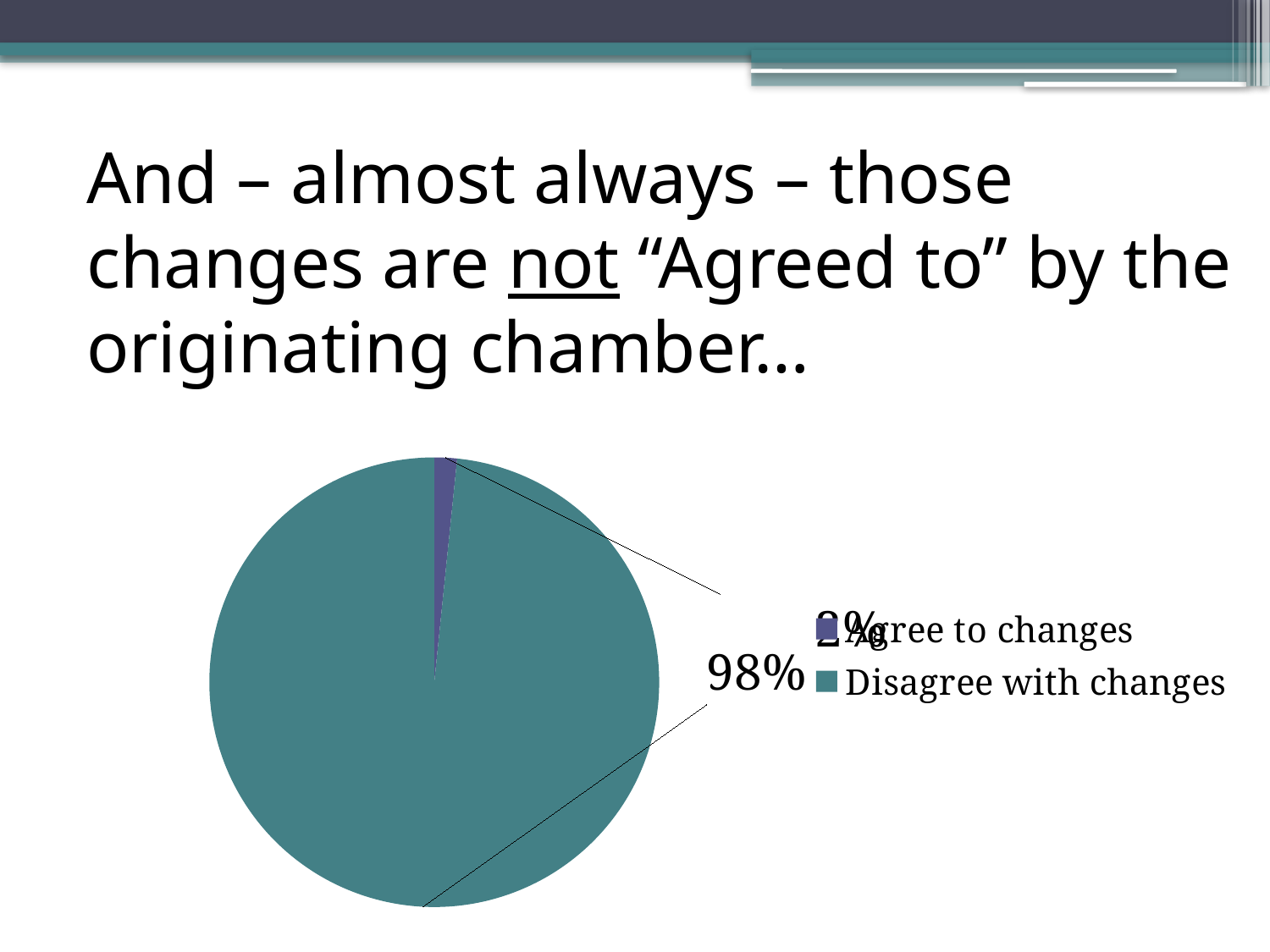
What colour is the "Disagree with changes" slice? teal How many entries does the legend list? 2 How many slices does the pie chart have? 2 Which is larger, the share for "Agree to changes" or the share for "Disagree with changes"? Disagree with changes What colour is the "Agree to changes" slice? purple What kind of chart is shown on the slide? pie chart What share of the pie does "Disagree with changes" represent? 98% What share of the pie does "Agree to changes" represent? 2% What is the difference in percentage points between the "Disagree with changes" slice and the "Agree to changes" slice? 96 Which slice of the pie is the largest? Disagree with changes Which slice of the pie is the smallest? Agree to changes